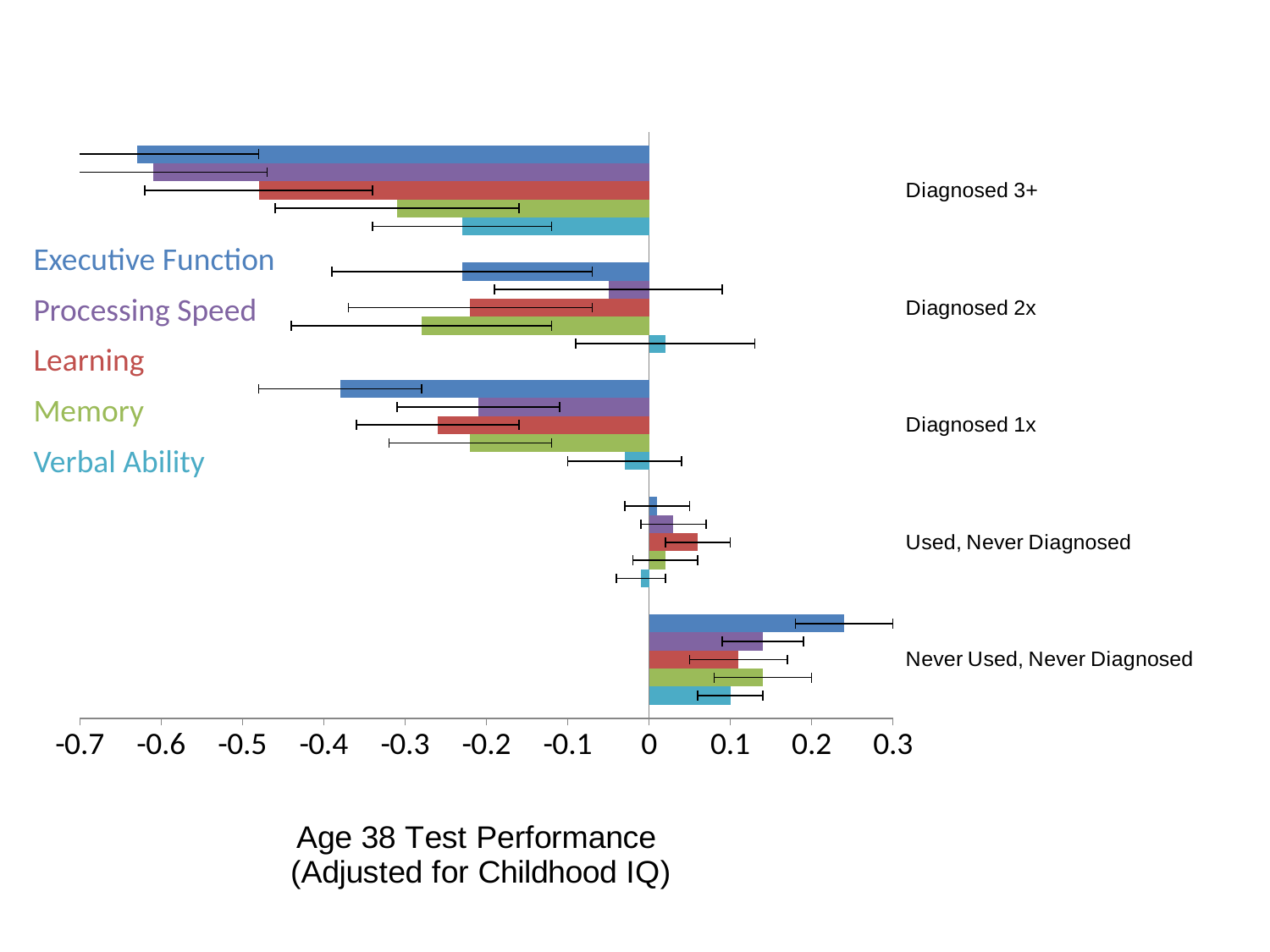
Is the Executive Function value for Diagnosed 3+ greater or less than -0.5? less Is the Learning value for Diagnosed 3+ greater or less than -0.4? less Within the Diagnosed 3+ group, which has the lower value: Executive Function or Verbal Ability? Executive Function Is the Executive Function value for Never Used, Never Diagnosed greater or less than 0.2? greater Across the groups, which group has the lowest Executive Function value? Diagnosed 3+ Within the Never Used, Never Diagnosed group, which series has the highest value? Executive Function What kind of chart is shown on the slide? bar chart How many series does the legend list? 5 What is the title shown below the chart? Age 38 Test Performance (Adjusted for Childhood IQ) How many groups (categories) are plotted on the chart? 5 What colour represents the Learning series? red